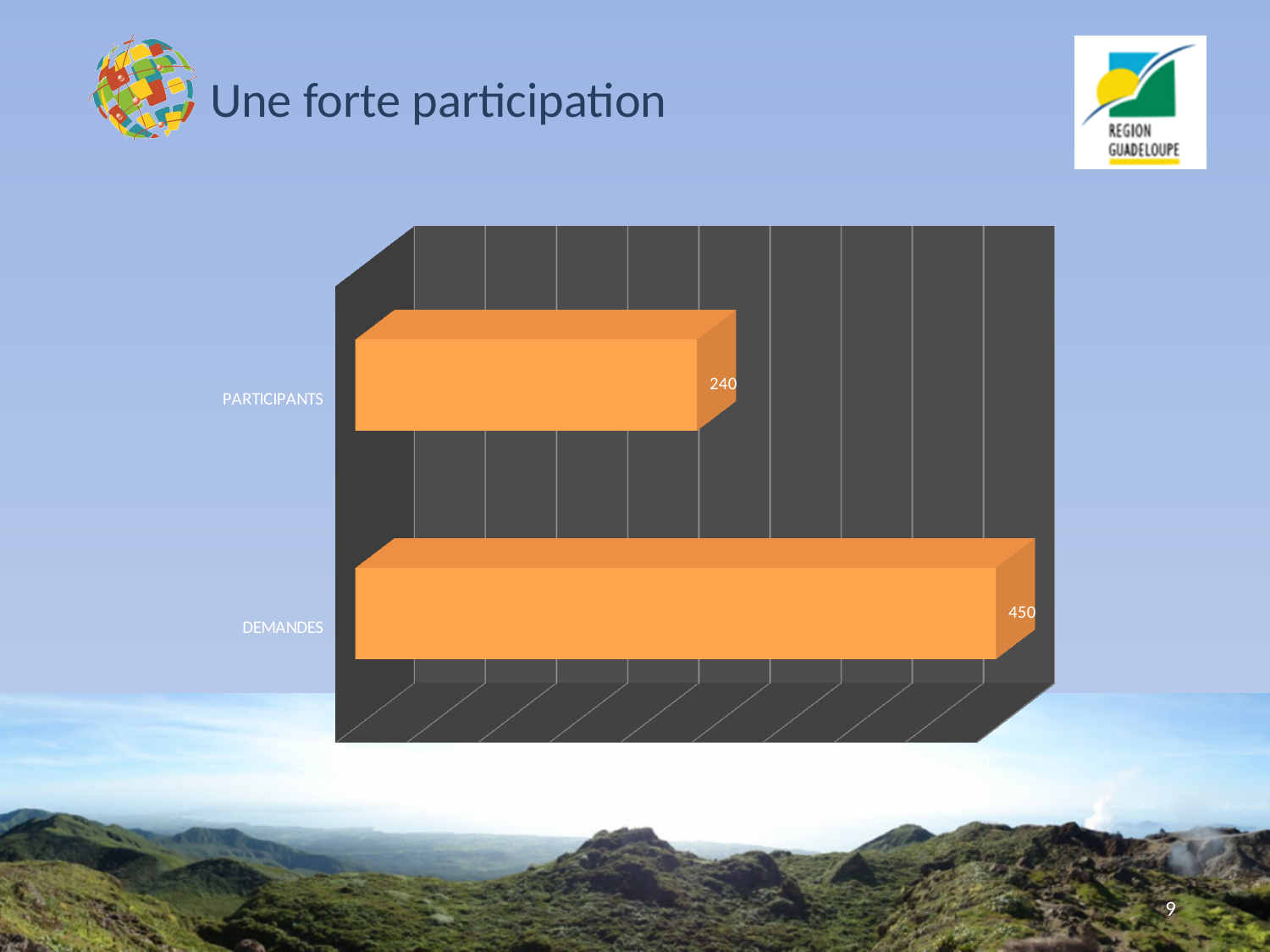
What colour are the bars in the chart? orange How many categories are shown in the chart? 2 Which category has the highest value? DEMANDES What is the difference between the values for DEMANDES and PARTICIPANTS? 210 What is the title of the slide containing the chart? Une forte participation What is the value for DEMANDES? 450 Which category has the lowest value? PARTICIPANTS Which is larger, the value for PARTICIPANTS or the value for DEMANDES? DEMANDES What is the value for PARTICIPANTS? 240 What is the total of the values for PARTICIPANTS and DEMANDES? 690 What kind of chart is shown on the slide? bar chart